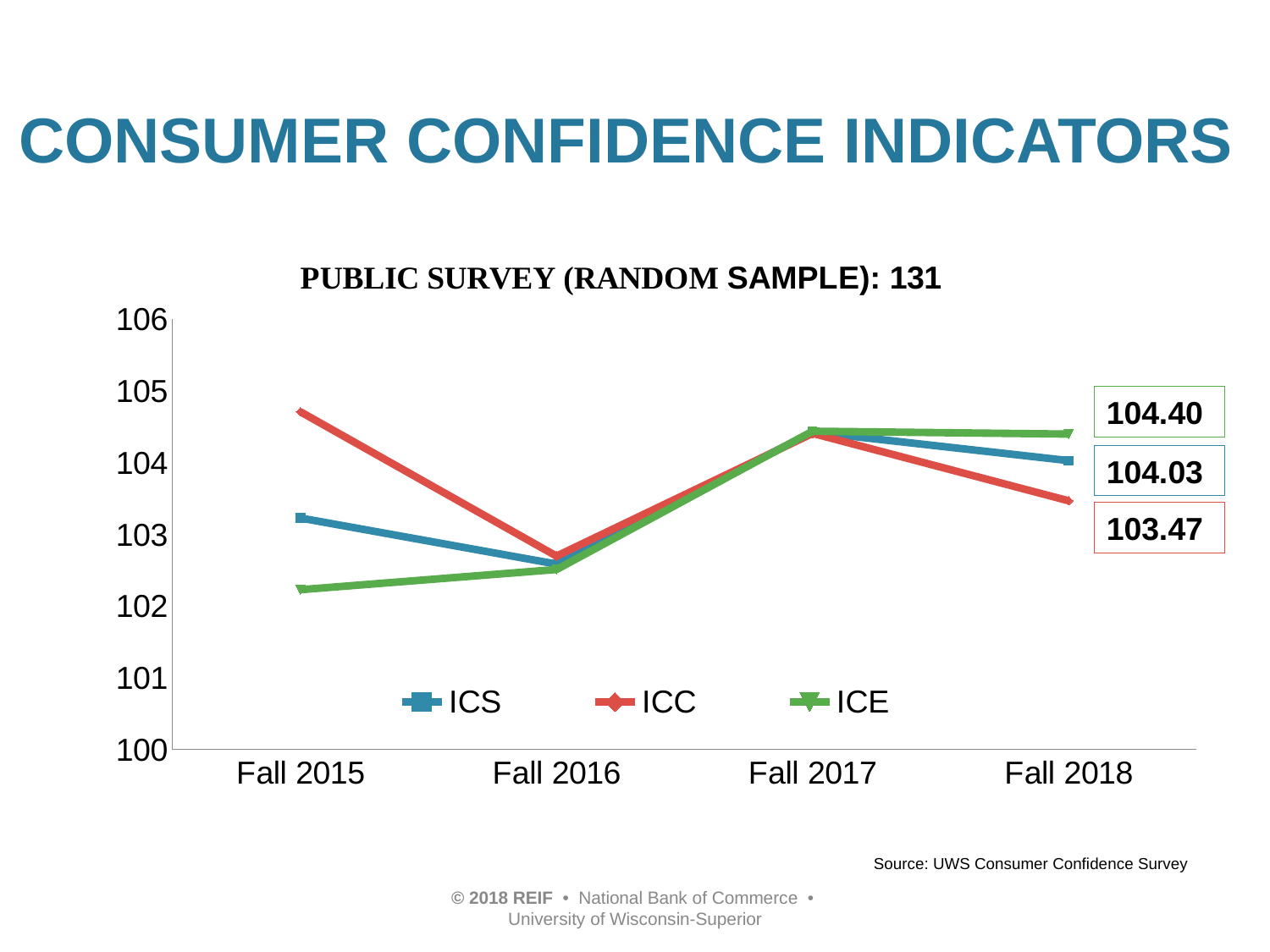
How many series does the legend list? 3 Which series has the lowest value in Fall 2018? ICC Is the value for ICC in Fall 2015 greater or less than 104? greater What is the value of ICE in Fall 2018? 104.40 What is the difference between the ICE and ICC values in Fall 2018? 0.93 How many time periods are shown on the x axis? 4 Is the value for ICE in Fall 2015 greater or less than 103? less What is the value of ICS in Fall 2018? 104.03 Which is larger in Fall 2015, ICC or ICS? ICC Which series has the highest value in Fall 2018? ICE What kind of chart is shown on the slide? Line chart What is the value of ICC in Fall 2018? 103.47